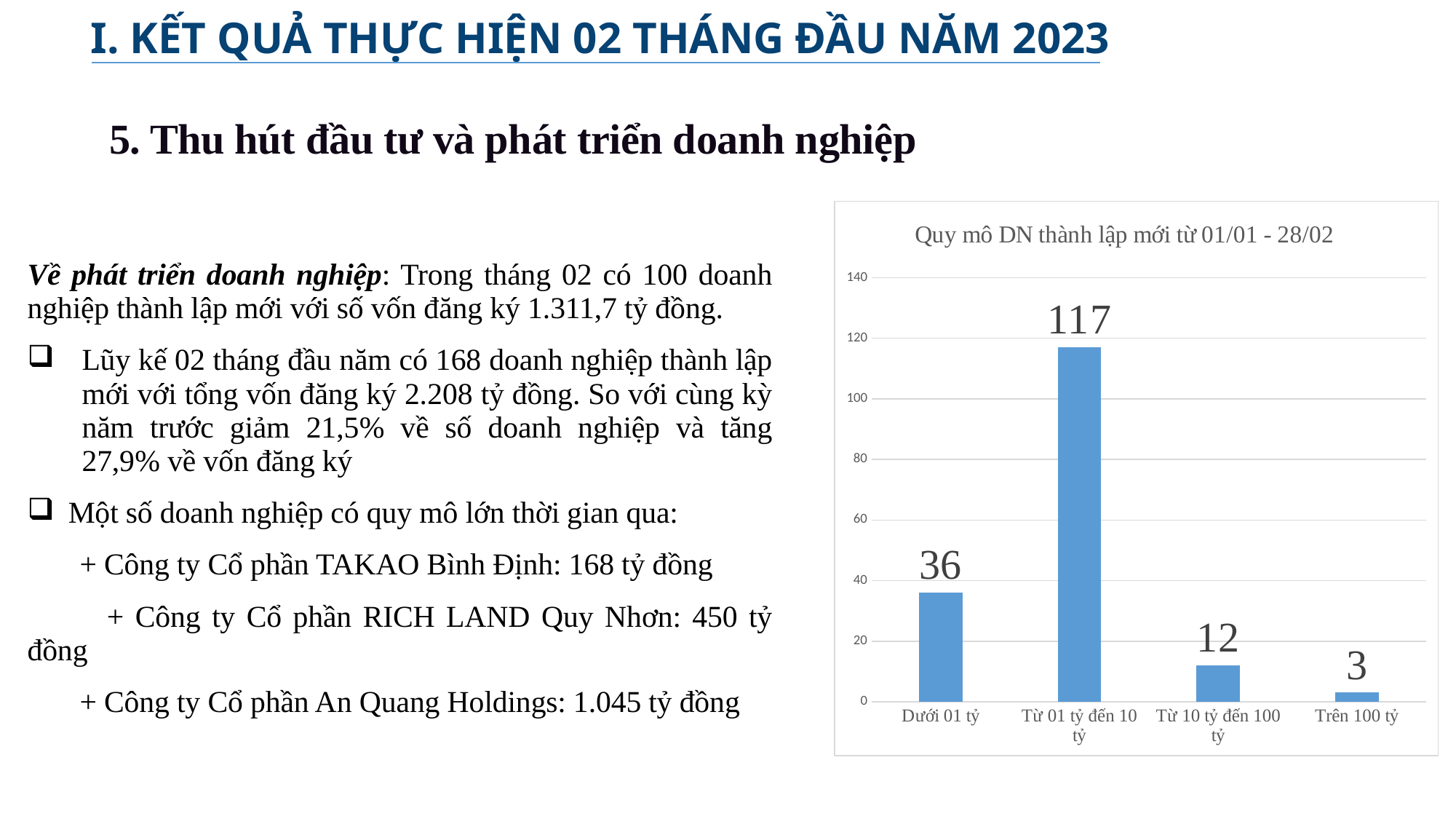
What is the value for "Từ 01 tỷ đến 10 tỷ"? 117 What is the difference between the values for "Từ 01 tỷ đến 10 tỷ" and "Dưới 01 tỷ"? 81 What is the title of the chart? Quy mô DN thành lập mới từ 01/01 - 28/02 What is the value for "Từ 10 tỷ đến 100 tỷ"? 12 What kind of chart is shown on the slide? bar chart How many categories are shown on the x axis? 4 Which category has the highest value? Từ 01 tỷ đến 10 tỷ Is the value for "Từ 01 tỷ đến 10 tỷ" greater or less than 100? greater What is the value for "Dưới 01 tỷ"? 36 Which is larger, the value for "Dưới 01 tỷ" or the value for "Từ 10 tỷ đến 100 tỷ"? Dưới 01 tỷ What is the value for "Trên 100 tỷ"? 3 Which category has the lowest value? Trên 100 tỷ